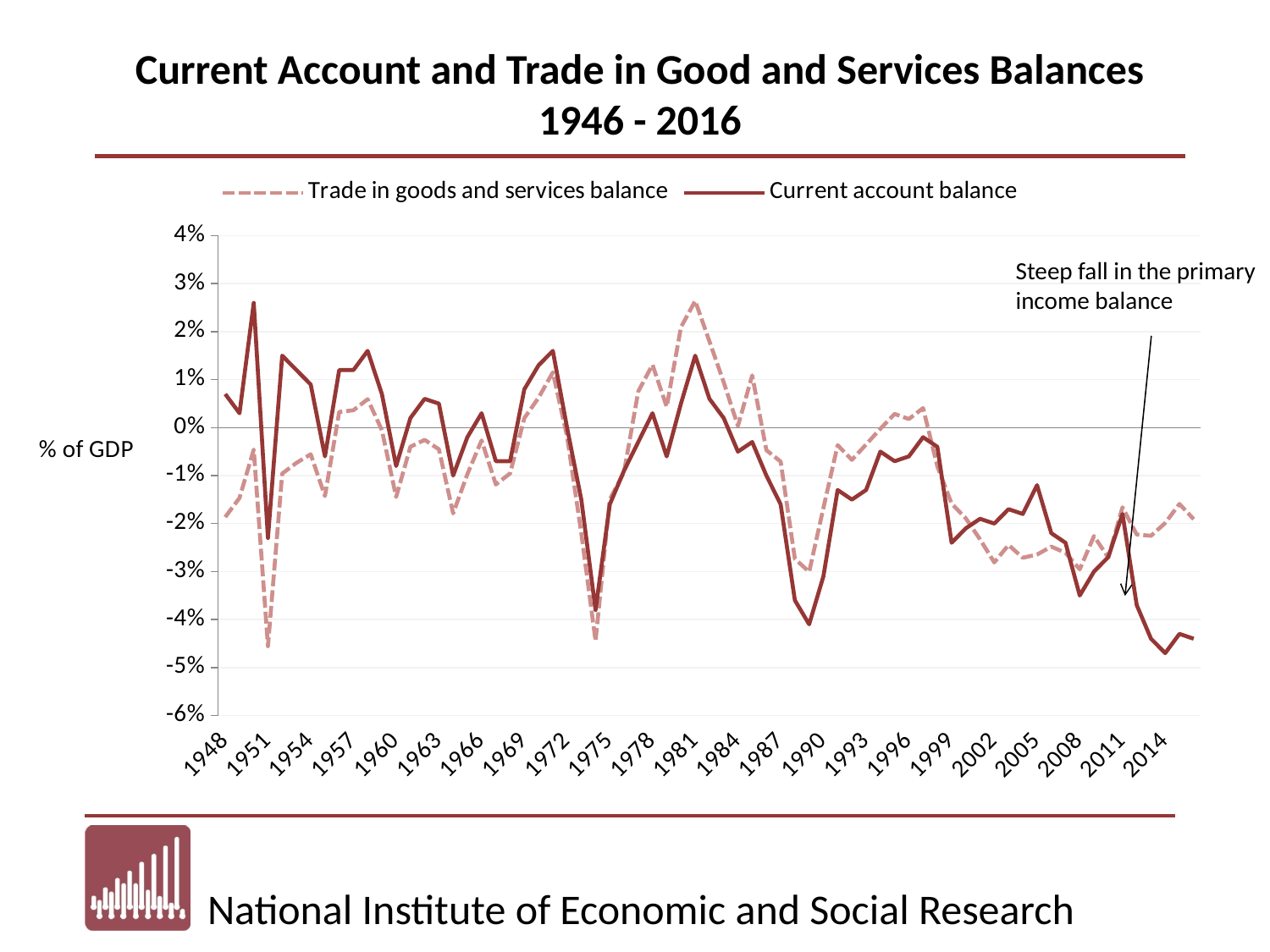
Is the trade in goods and services balance in 1951 greater or less than -4%? less In 2014, which series has the higher value: the trade in goods and services balance or the current account balance? Trade in goods and services balance What text does the annotation with the arrow on the chart say? Steep fall in the primary income balance Does the current account balance rise or fall between 2011 and 2014? Fall Is the current account balance in 2014 greater or less than -4%? less How many series does the legend list? 2 Is the current account balance in 1989 greater or less than -3%? less In 1951, which series has the higher value: the trade in goods and services balance or the current account balance? Current account balance What kind of chart is shown on the slide? Line chart What is the title of the chart? Current Account and Trade in Good and Services Balances 1946 - 2016